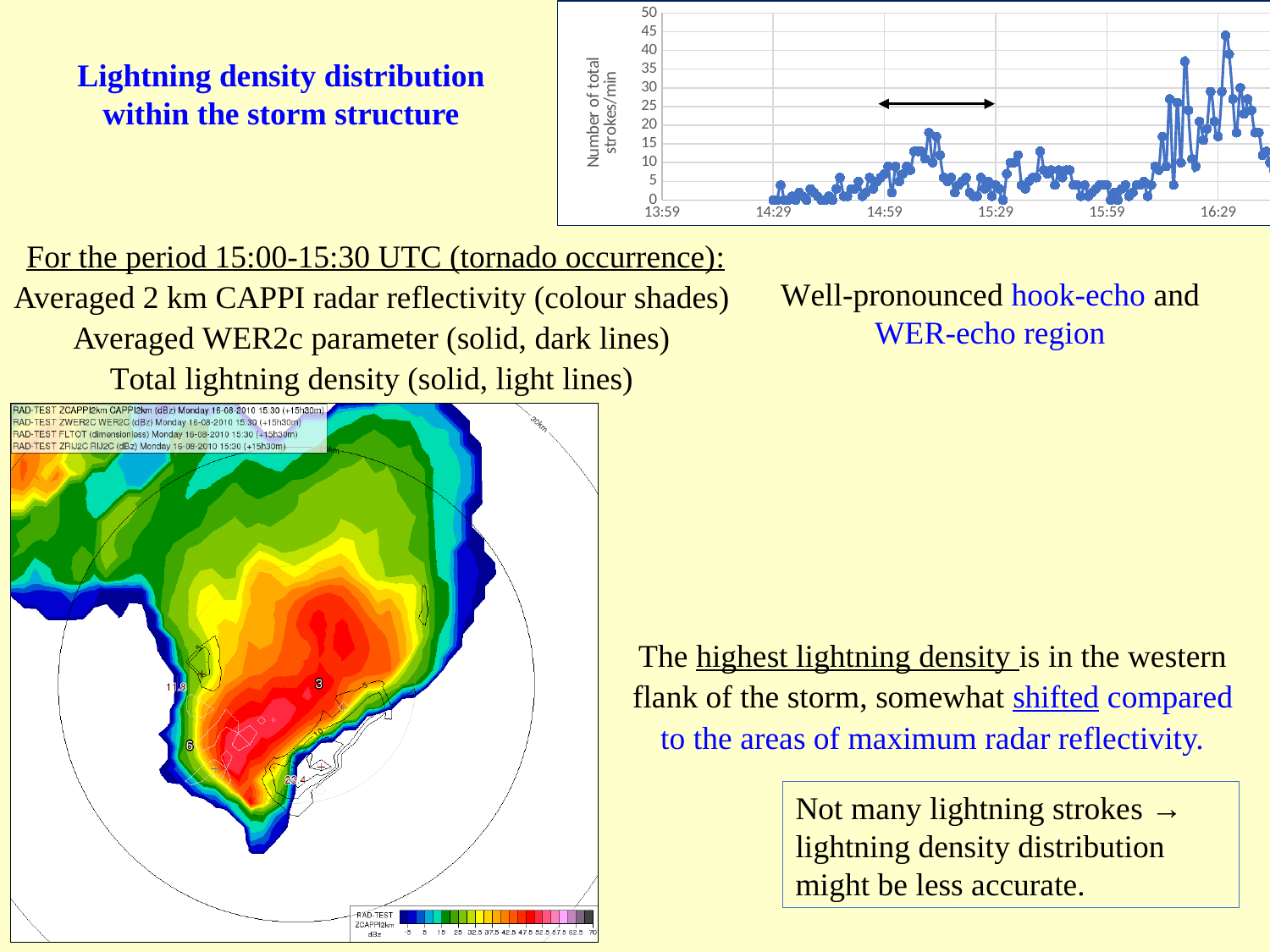
What is the last time label on the horizontal axis of the line chart? 16:29 What kind of chart is shown in the top right of the slide? line chart In the line chart, is the value at 14:29 greater or less than 5? less What is the first time label on the horizontal axis of the line chart? 13:59 How many time labels are shown along the horizontal axis of the line chart? 6 In the line chart, is the highest peak of strokes per minute greater or less than 40? greater In the line chart, is the peak between 14:59 and 15:29 higher or lower than the peak after 15:59? lower What is the label on the vertical axis of the line chart? Number of total strokes/min In the line chart, do the number of strokes per minute generally rise or fall from 13:59 to 16:29? rise In the line chart, is the peak between 14:59 and 15:29 greater or less than 25? less What is the highest value shown on the vertical axis of the line chart? 50